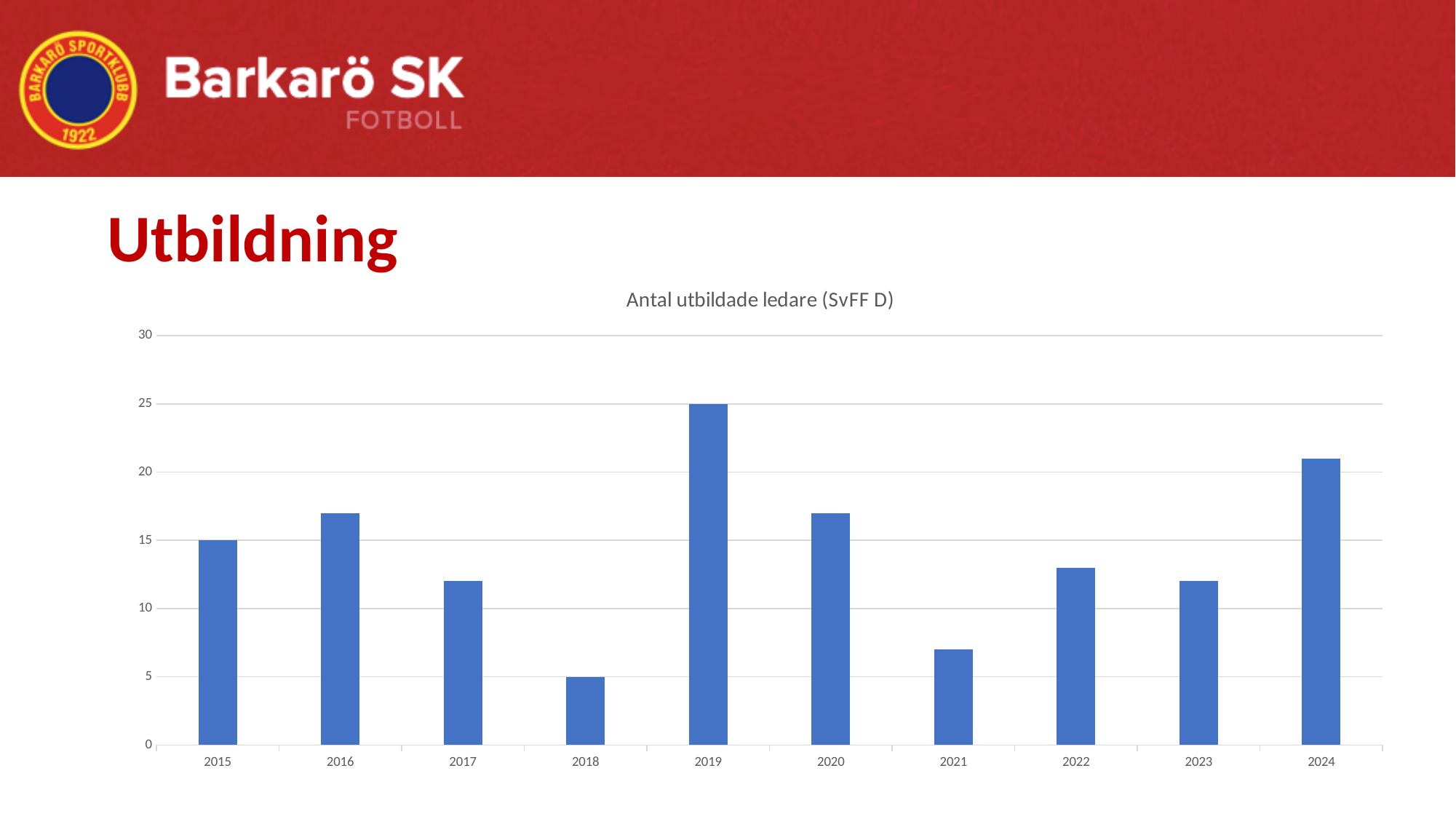
Which is larger, the value for 2019 or the value for 2024? 2019 What is the difference between the values for 2019 and 2018? 20 What is the value for 2019? 25 Which year has the lowest value? 2018 What is the value for 2015? 15 Is the value for 2021 greater or less than 10? less Is the value for 2024 greater or less than 20? greater How many years are shown on the x axis? 10 Which year has the highest value? 2019 What is the value for 2018? 5 What kind of chart is shown on the slide? bar chart What is the title of the chart? Antal utbildade ledare (SvFF D)